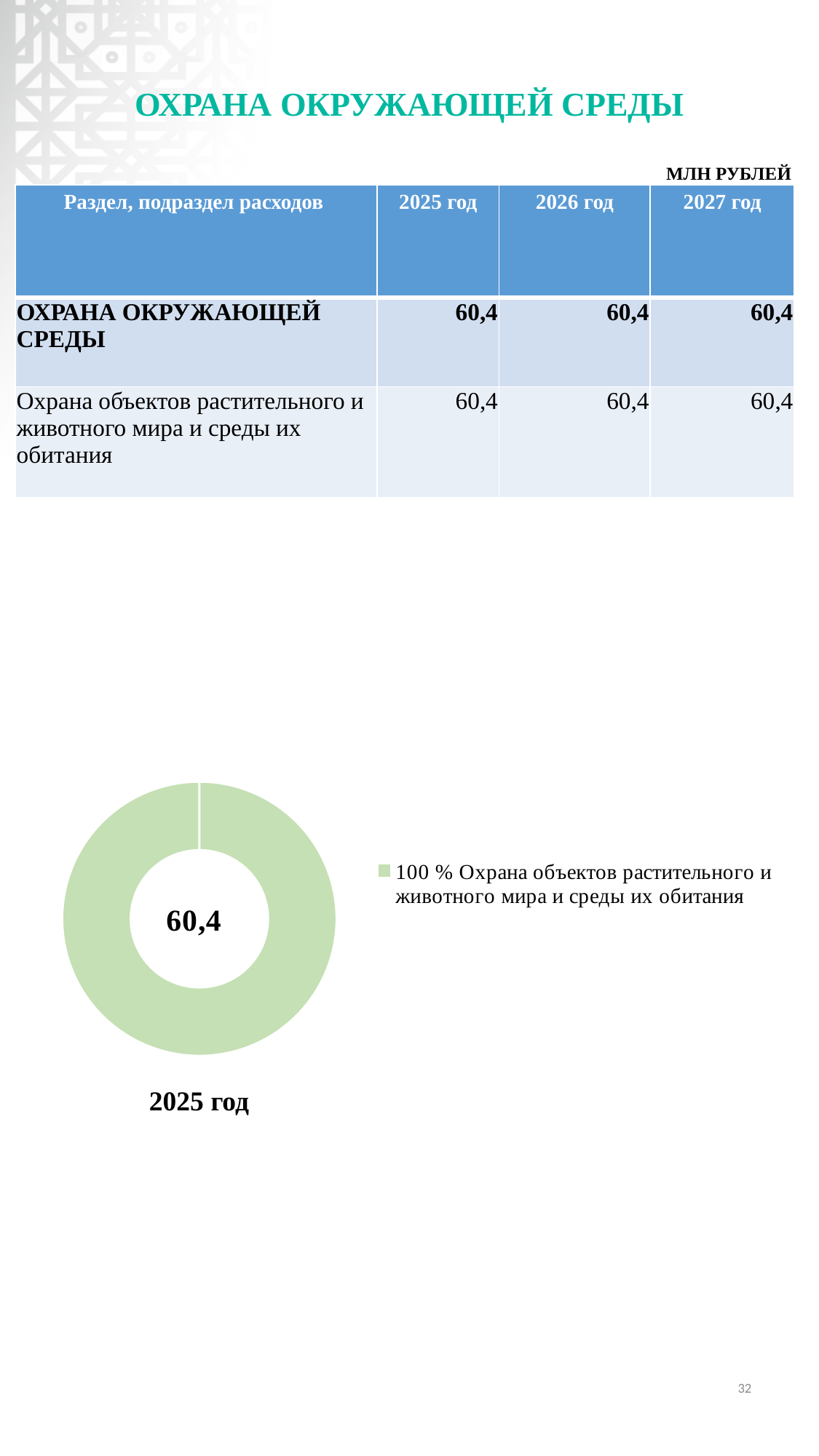
Which year is the doughnut chart labelled with? 2025 год What kind of chart is shown at the bottom of the slide? Doughnut chart What share of the doughnut chart does "Охрана объектов растительного и животного мира и среды их обитания" take? 100 % What colour is the slice in the doughnut chart? Light green How many slices does the doughnut chart have? 1 Is the value shown in the centre of the doughnut chart greater or less than 50? greater What is the legend entry of the doughnut chart? 100 % Охрана объектов растительного и животного мира и среды их обитания What value is printed in the centre of the doughnut chart? 60,4 How many entries does the legend of the doughnut chart list? 1